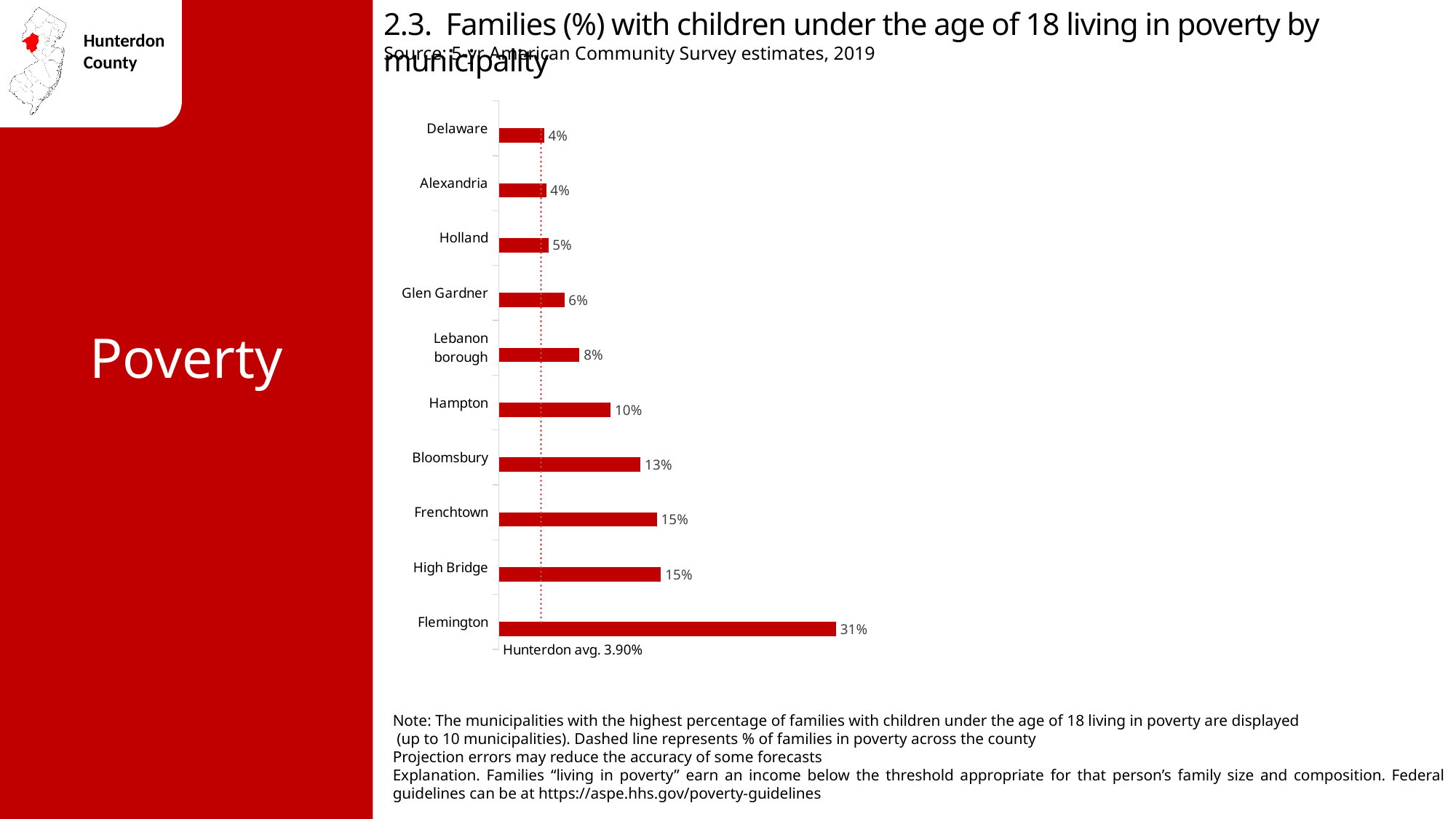
What is the value shown for Hampton? 10% What is the difference between the values for Bloomsbury and Glen Gardner? 7% Which municipality has the highest percentage of families with children under 18 living in poverty? Flemington How many municipalities are shown in the chart? 10 What is the difference between the values for Flemington and Frenchtown? 16% What kind of chart is shown on the slide? Bar chart Which has a higher value, Bloomsbury or Lebanon borough? Bloomsbury Which has a higher value, Hampton or Holland? Hampton What is the value shown for Glen Gardner? 6% What percentage of families with children under 18 are living in poverty in Flemington? 31% What is the value shown for Lebanon borough? 8% What Hunterdon County average does the dashed line represent? 3.90%